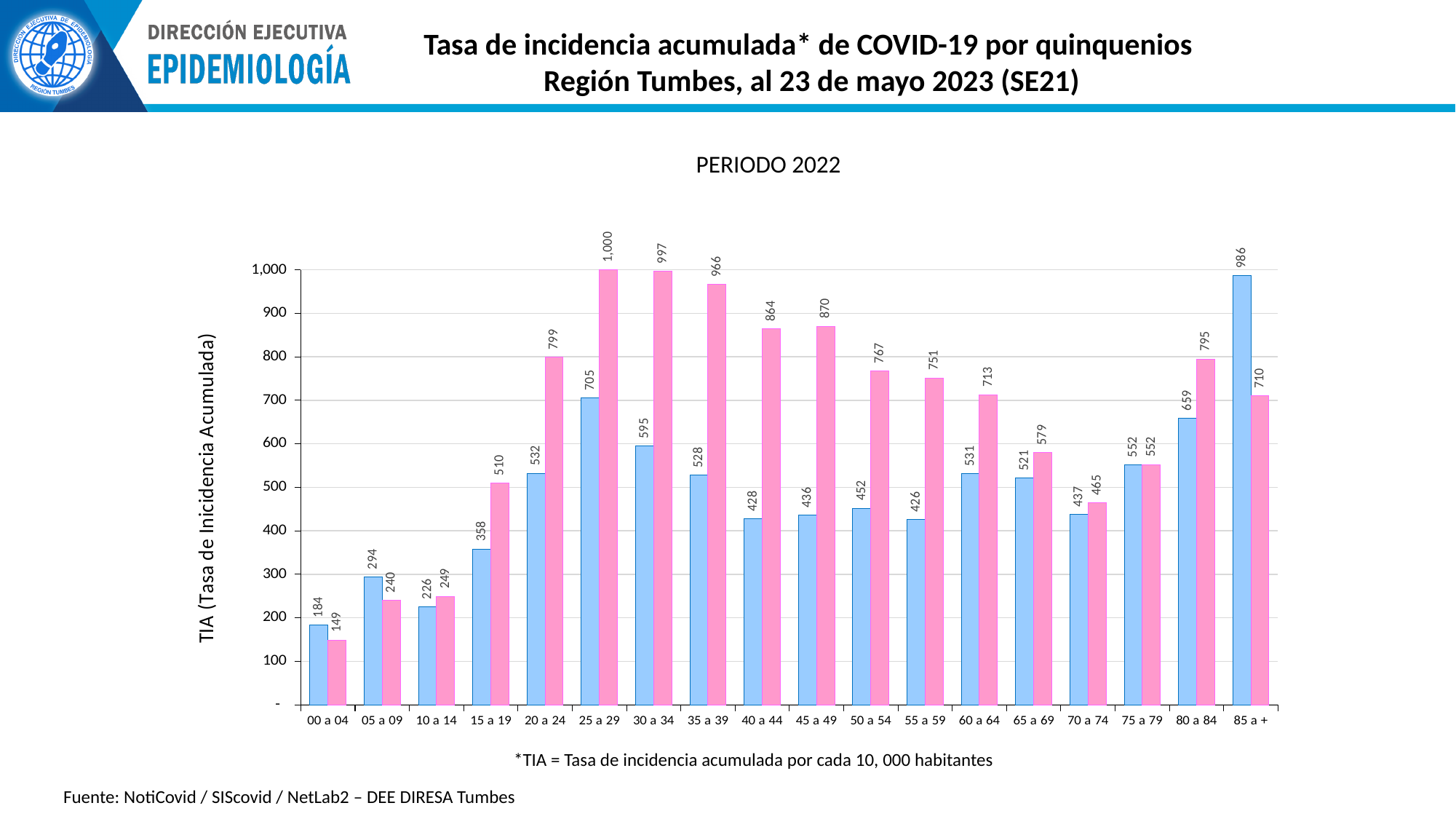
What is the difference between the pink bar and the blue bar for the 20 a 24 age group? 267 Which is larger for the 10 a 14 age group, the blue bar or the pink bar? the pink bar What is the value of the blue bar for the 25 a 29 age group? 705 What is the value of the pink bar for the 40 a 44 age group? 864 Which age group has the highest pink bar? 25 a 29 What is the difference between the blue bar and the pink bar for the 85 a + age group? 276 What is the title shown above the chart? PERIODO 2022 How many age groups are shown on the x axis? 18 Is the pink bar for the 30 a 34 age group greater or less than 900? greater Which age group has the lowest blue bar? 00 a 04 What kind of chart is shown on the slide? bar chart What is the value of the blue bar for the 85 a + age group? 986